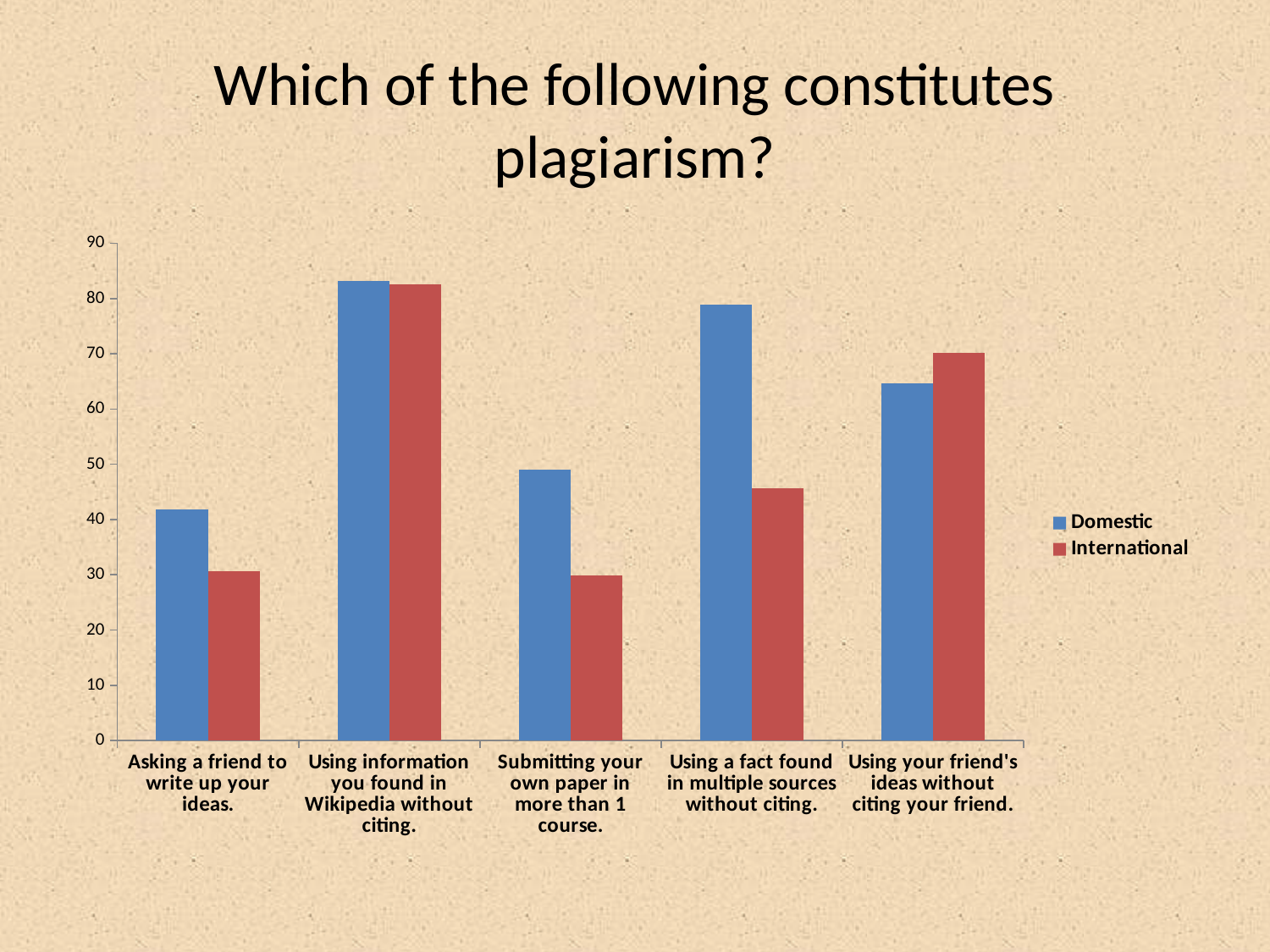
Which category has the highest International value? Using information you found in Wikipedia without citing. How many categories are shown on the x axis? 5 For 'Using your friend's ideas without citing your friend.', which series has the larger value, Domestic or International? International What kind of chart is shown on the slide? bar chart What is the title of the chart? Which of the following constitutes plagiarism? How many series does the legend list? 2 Which category has the highest Domestic value? Using information you found in Wikipedia without citing. Is the International value for 'Asking a friend to write up your ideas.' greater or less than 40? less Which category has the lowest Domestic value? Asking a friend to write up your ideas. Is the Domestic value for 'Using information you found in Wikipedia without citing.' greater or less than 80? greater Is the International value for 'Using a fact found in multiple sources without citing.' greater or less than 50? less